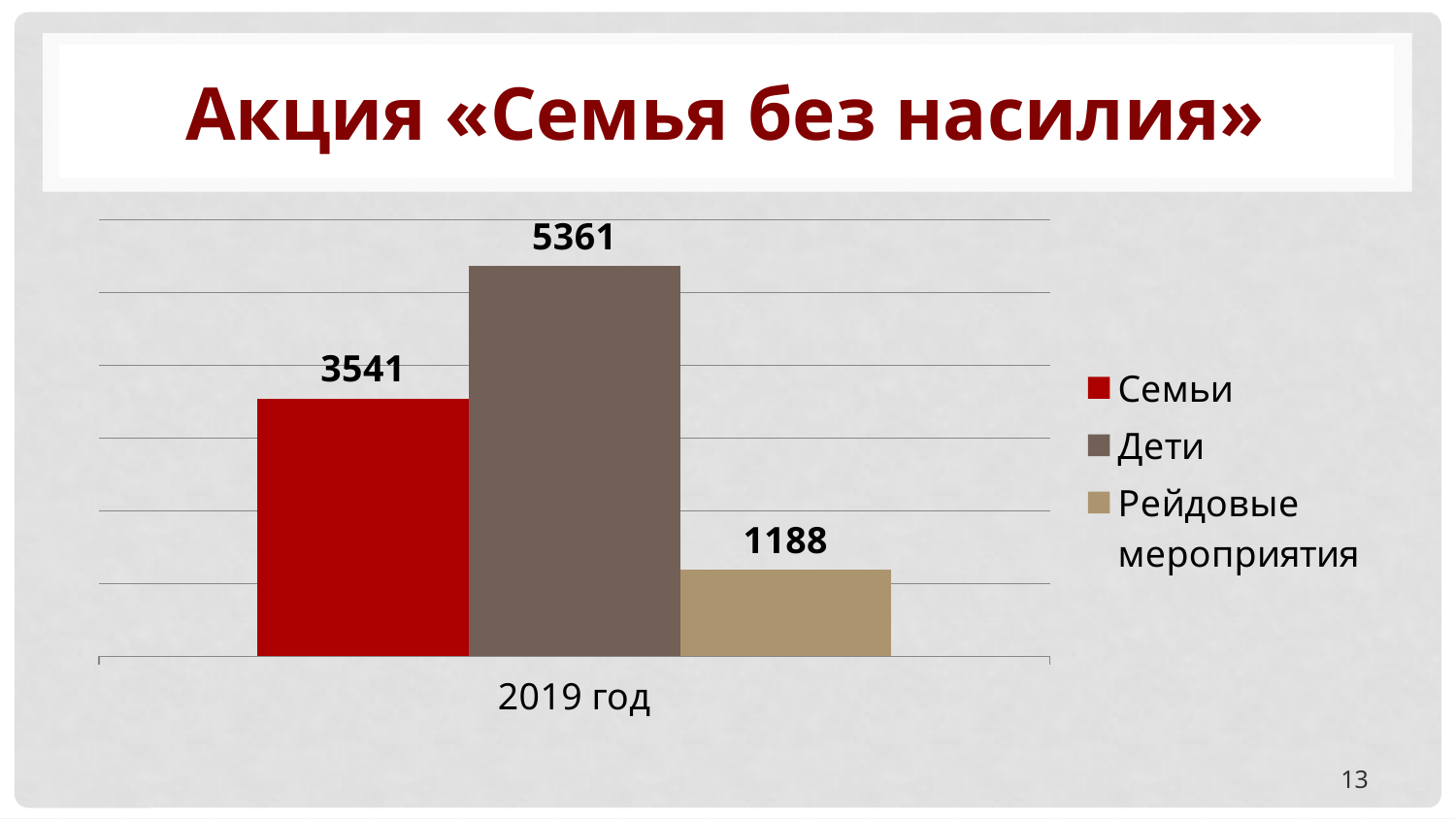
What kind of chart is shown on the slide? bar chart What colour is the bar for Семьи? red What is the title of the slide containing the chart? Акция «Семья без насилия» Which series has the lowest value? Рейдовые мероприятия What is the value for Семьи in 2019 год? 3541 What is the value for Рейдовые мероприятия in 2019 год? 1188 What is the difference between the values for Семьи and Рейдовые мероприятия? 2353 What is the difference between the values for Дети and Семьи? 1820 Which is larger, the value for Семьи or the value for Рейдовые мероприятия? Семьи How many series does the legend list? 3 Which series has the highest value? Дети What is the value for Дети in 2019 год? 5361